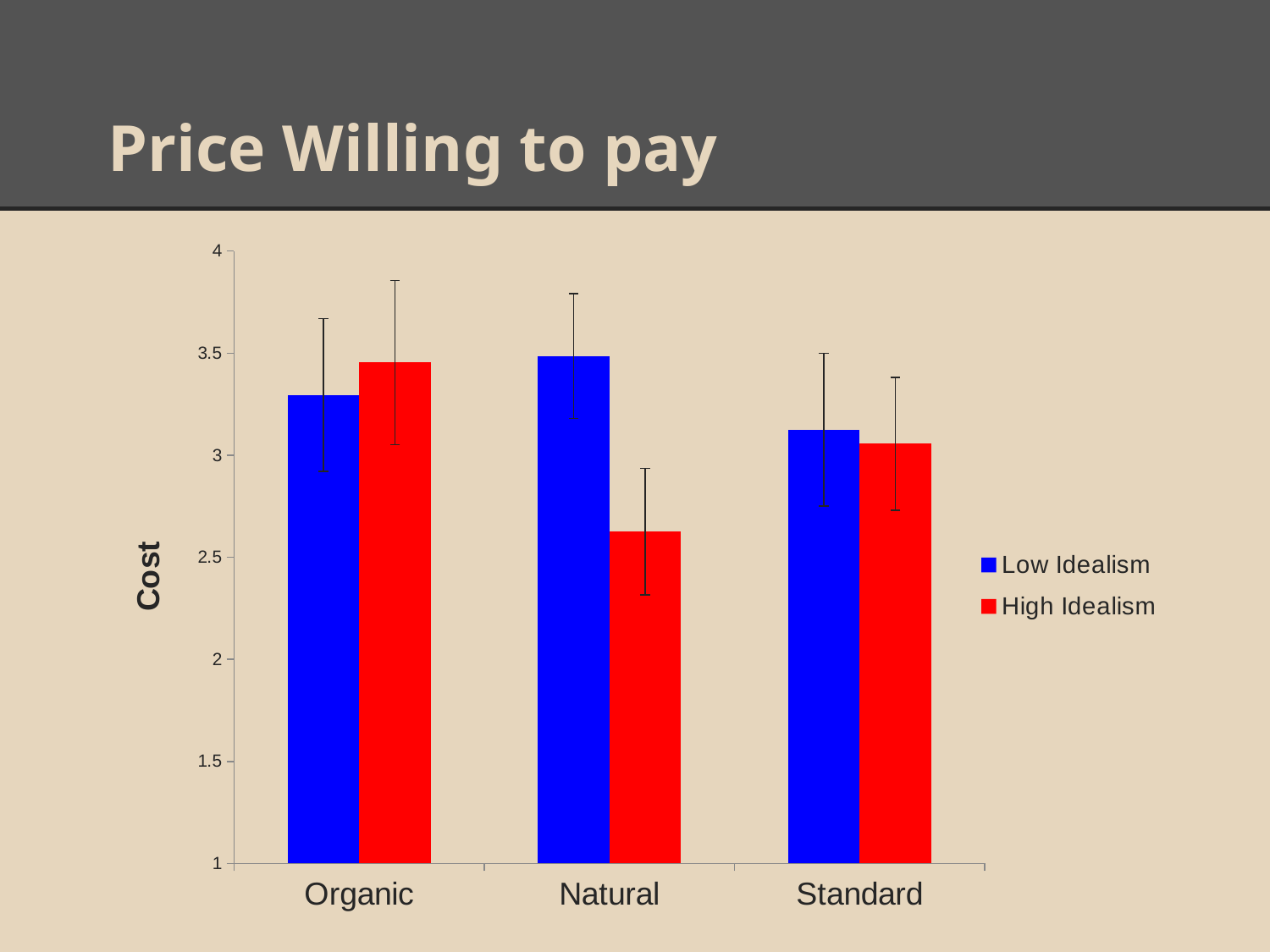
Is the Low Idealism value for Standard greater or less than 3? greater What is the title of the slide? Price Willing to pay What kind of chart is shown on the slide? Bar chart How many categories are shown on the x axis? 3 Which category has the lowest High Idealism value? Natural Is the High Idealism value for Natural greater or less than 3? less For Natural, which is larger: Low Idealism or High Idealism? Low Idealism Is the Low Idealism value for Organic greater or less than 3? greater What is the label on the y axis? Cost How many series does the legend list? 2 Which category has the highest Low Idealism value? Natural